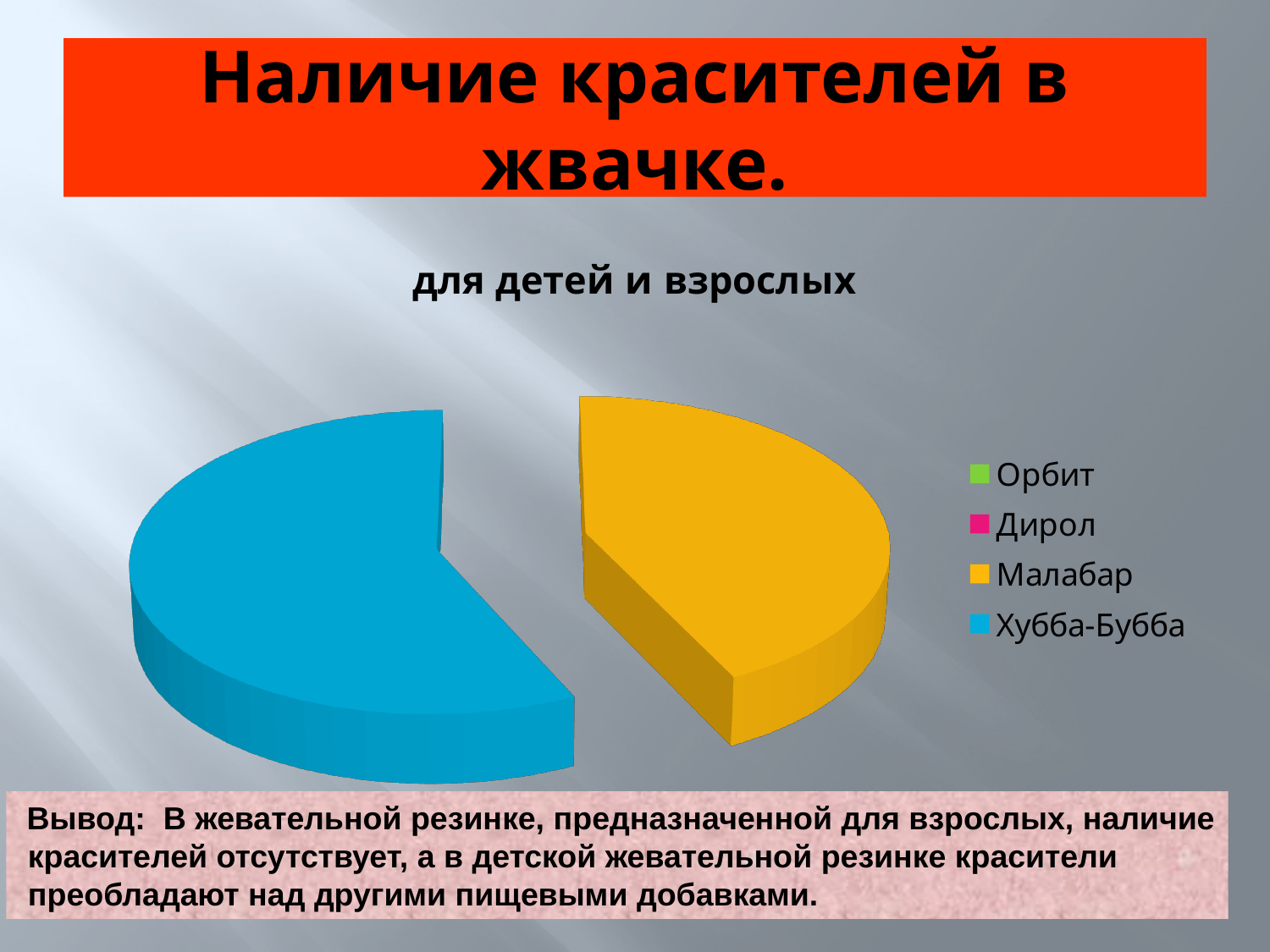
How many entries does the chart's legend list? 4 Which slice is larger, Хубба-Бубба or Малабар? Хубба-Бубба Which legend entries have no visible slice in the pie? Орбит and Дирол What kind of chart is shown on the slide? pie chart What colour is the Малабар slice? yellow Which category has the largest slice of the pie? Хубба-Бубба How many slices are visible in the pie? 2 What is the title of the chart? для детей и взрослых